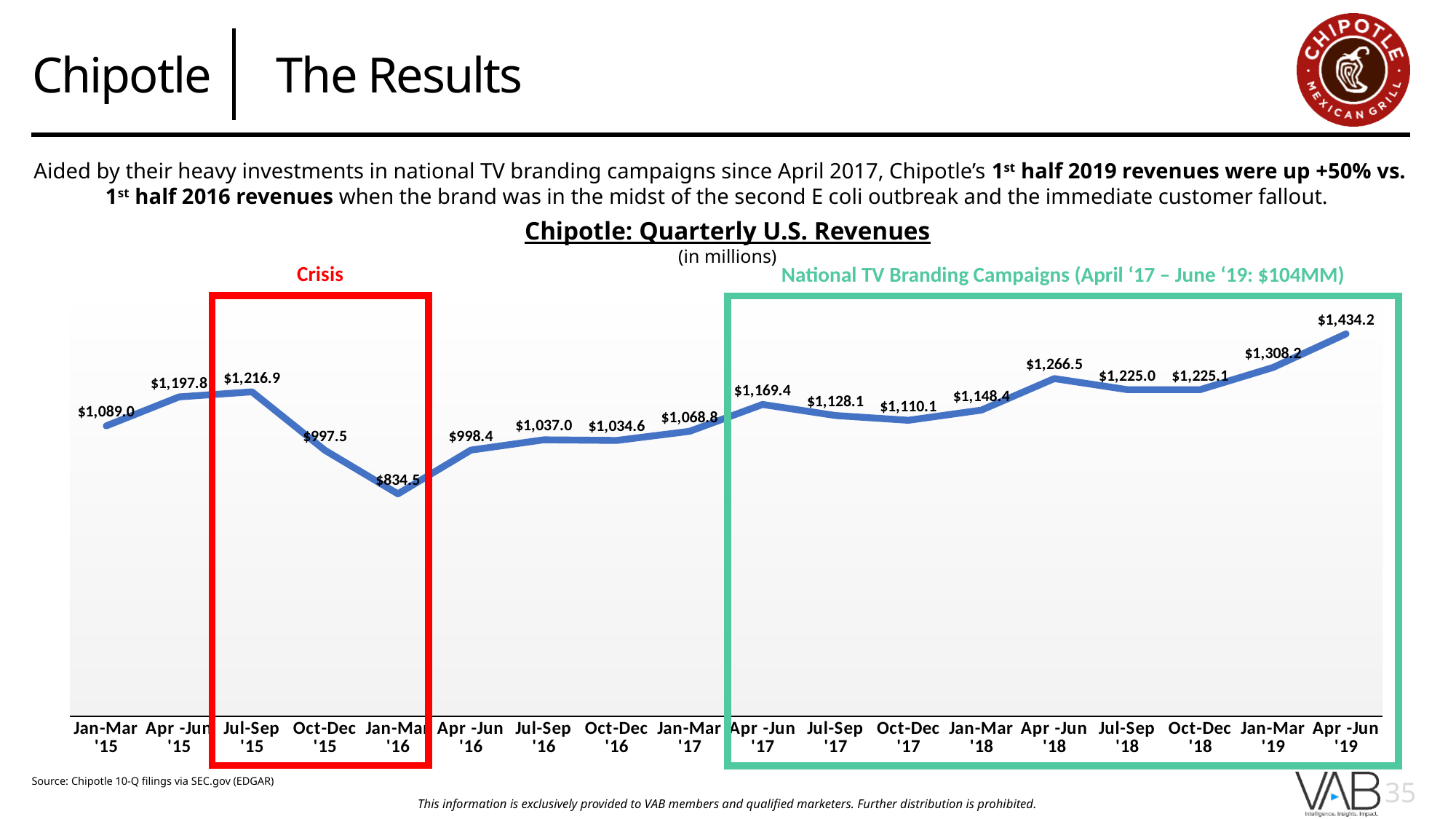
Which quarter has the lowest U.S. revenue on the chart? Jan-Mar '16 What was Chipotle's quarterly U.S. revenue for Jan-Mar '16? $834.5 Do revenues rise or fall from Jul-Sep '15 to Jan-Mar '16? Fall What is the difference between the revenue for Jul-Sep '15 and the revenue for Oct-Dec '15? $219.4 What is the difference between the revenue for Apr-Jun '19 and the revenue for Jan-Mar '16? $599.7 Which quarter has the highest U.S. revenue on the chart? Apr-Jun '19 What label is shown above the red box on the chart? Crisis How many quarters are plotted on the chart? 18 What kind of chart is shown on the slide? Line chart Which quarter had higher revenue, Jan-Mar '17 or Apr-Jun '17? Apr-Jun '17 What was Chipotle's quarterly U.S. revenue for Apr-Jun '18? $1,266.5 What was Chipotle's quarterly U.S. revenue for Apr-Jun '19? $1,434.2